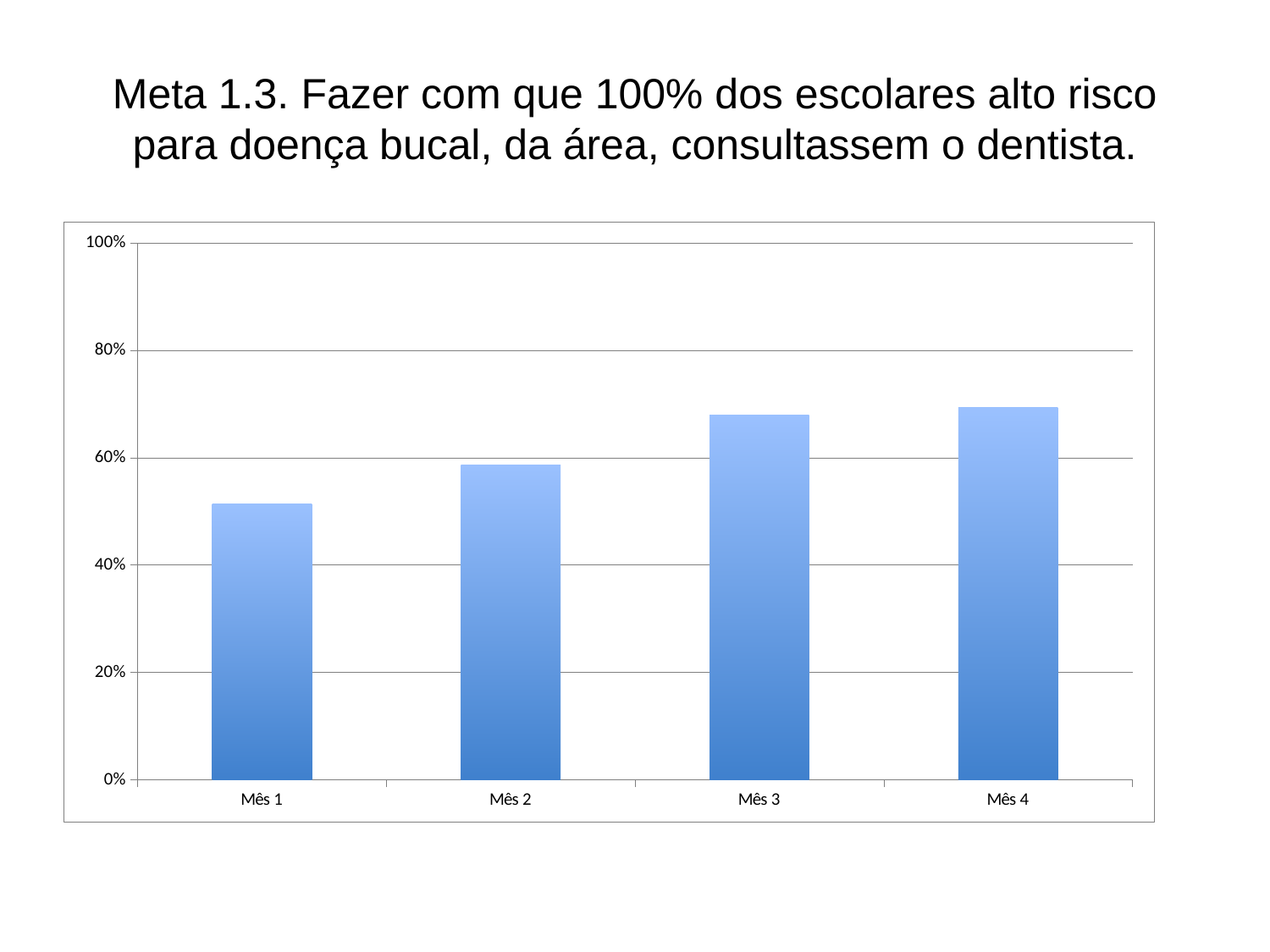
What kind of chart is shown on the slide? bar chart Which is larger, the value for Mês 1 or the value for Mês 3? Mês 3 Is the value for Mês 1 greater or less than 60%? less Is the value for Mês 4 greater or less than 80%? less Is the value for Mês 3 greater or less than 60%? greater What is the highest value shown on the y axis? 100% Which is larger, the value for Mês 2 or the value for Mês 4? Mês 4 Do the values rise or fall from Mês 1 to Mês 4? rise Which month has the lowest value? Mês 1 What is the label of the third category on the x axis? Mês 3 How many categories (months) are plotted on the x axis? 4